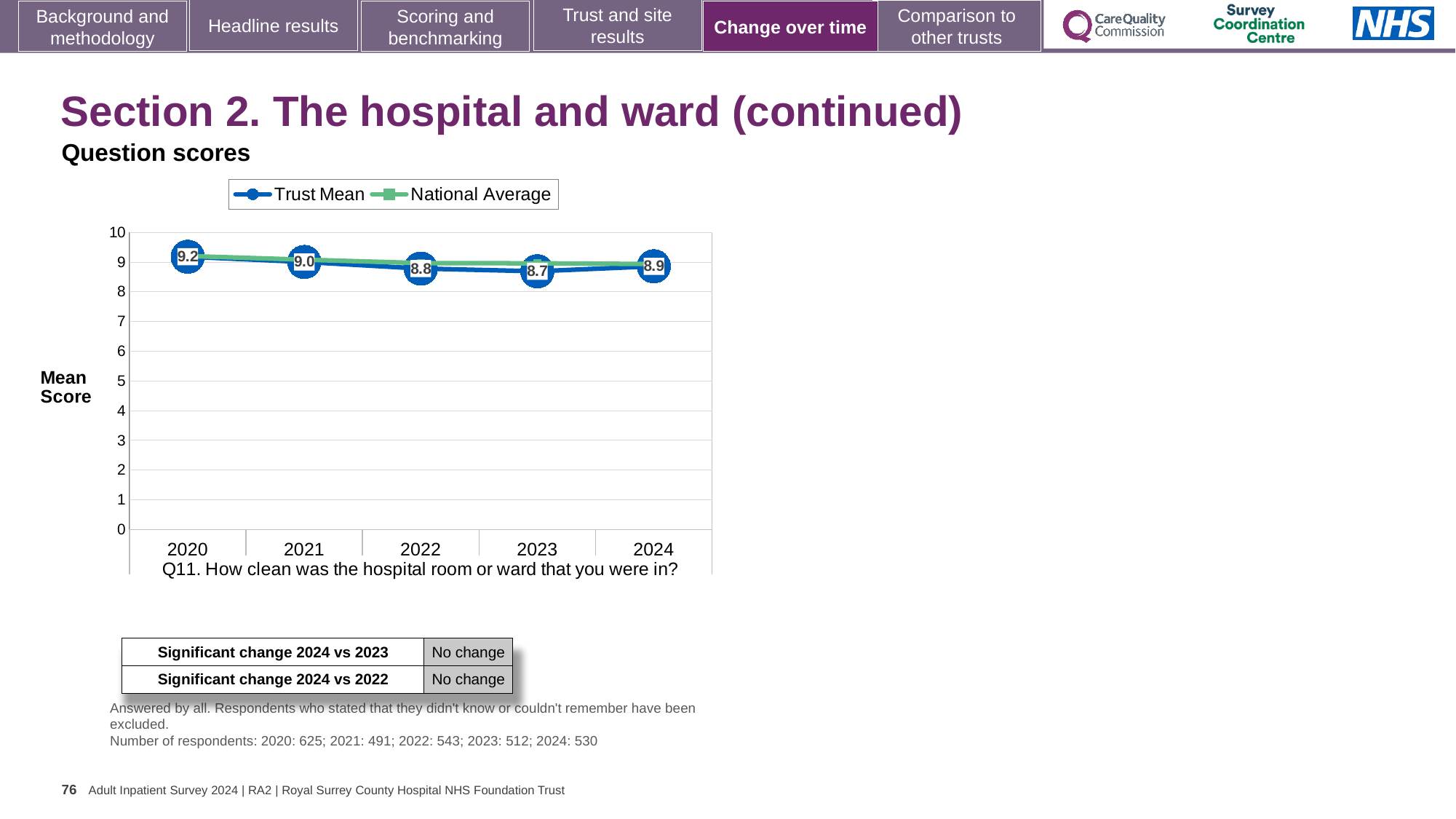
In which year is the Trust Mean score highest? 2020 Does the Trust Mean score rise or fall from 2020 to 2023? Fall What is the Trust Mean score for 2024? 8.9 In which year is the Trust Mean score lowest? 2023 Which year has the larger Trust Mean score, 2021 or 2022? 2021 What is the difference between the Trust Mean score in 2020 and in 2023? 0.5 What kind of chart is shown on the slide? Line chart What is the Trust Mean score for 2020? 9.2 Is the National Average value for 2022 greater or less than 8? greater How many series does the legend list? 2 How many years are plotted on the x axis? 5 What is the Trust Mean score for 2023? 8.7